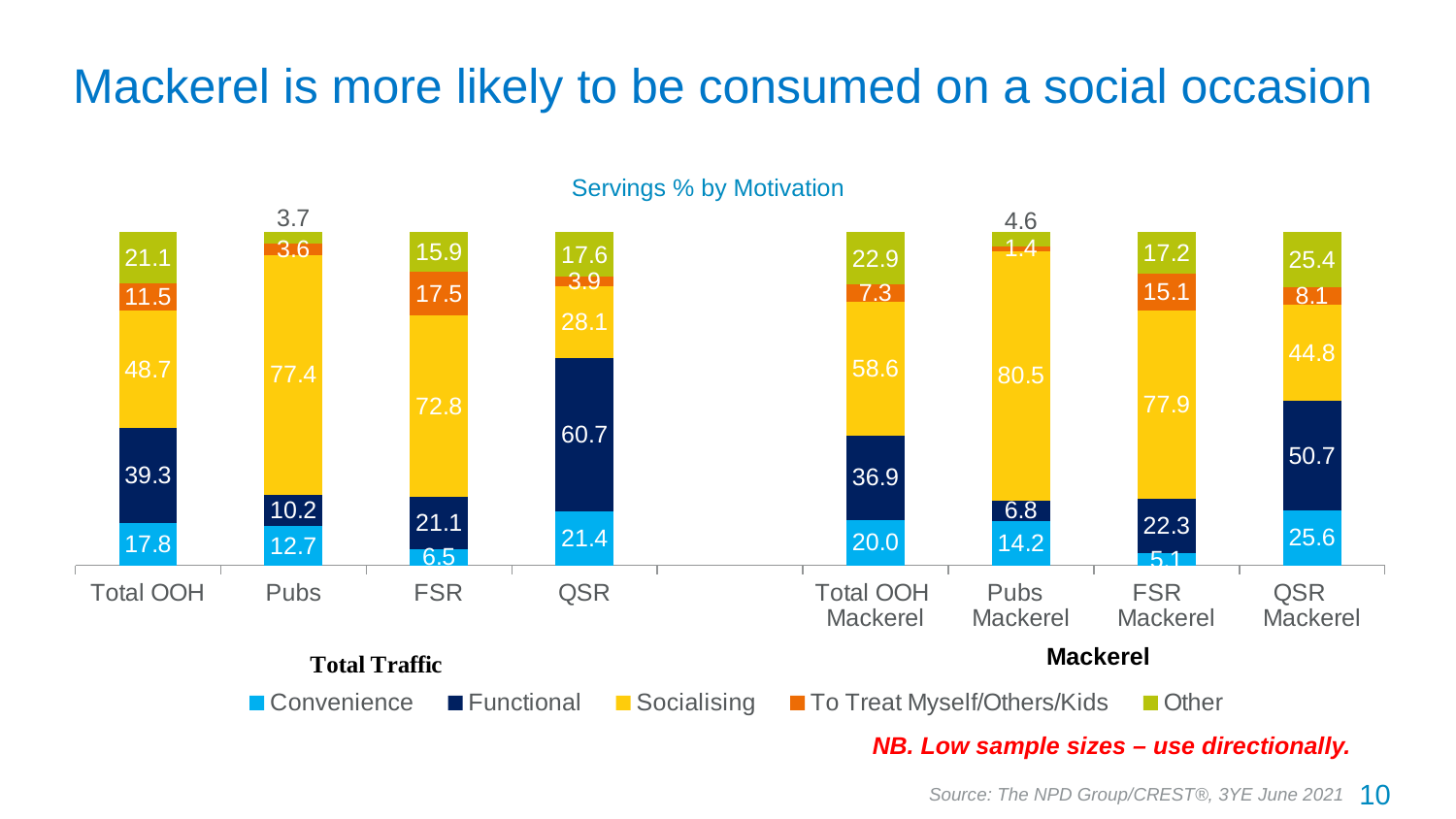
What is the Functional value for QSR? 60.7 What is the difference between the Socialising value for Total OOH Mackerel and for Total OOH? 9.9 Which is larger, the Functional value for QSR Mackerel or for QSR? QSR Which category has the lowest Convenience value? FSR Mackerel What is the Other value for Pubs? 3.7 How many categories are shown on the x axis? 8 What is the Convenience value for Total OOH Mackerel? 20.0 What is the title of the chart? Servings % by Motivation How many series does the legend list? 5 What kind of chart is shown on the slide? Stacked bar chart What is the Socialising value for Pubs Mackerel? 80.5 Which category has the highest Socialising value? Pubs Mackerel